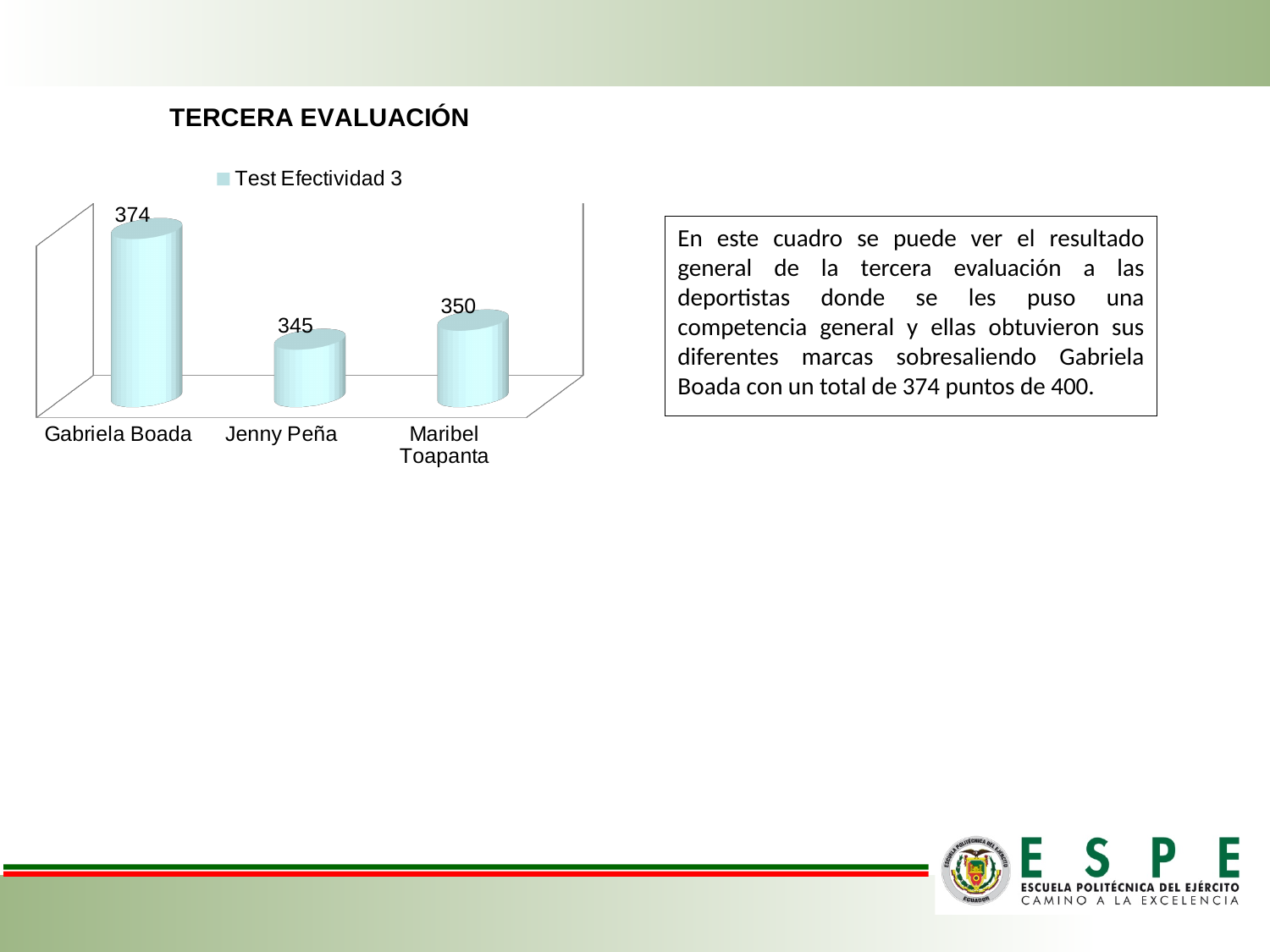
What is the difference between Gabriela Boada's and Jenny Peña's values? 29 Which athlete has the highest Test Efectividad 3 value? Gabriela Boada Which athlete has the lowest Test Efectividad 3 value? Jenny Peña Who has a higher value, Maribel Toapanta or Jenny Peña? Maribel Toapanta What is the Test Efectividad 3 value for Gabriela Boada? 374 What is the name of the series shown in the legend? Test Efectividad 3 How many series does the legend list? 1 What kind of chart is shown on the slide? Bar chart What is the Test Efectividad 3 value for Jenny Peña? 345 What is the Test Efectividad 3 value for Maribel Toapanta? 350 What is the difference between Maribel Toapanta's and Jenny Peña's values? 5 How many athletes are shown in the chart? 3